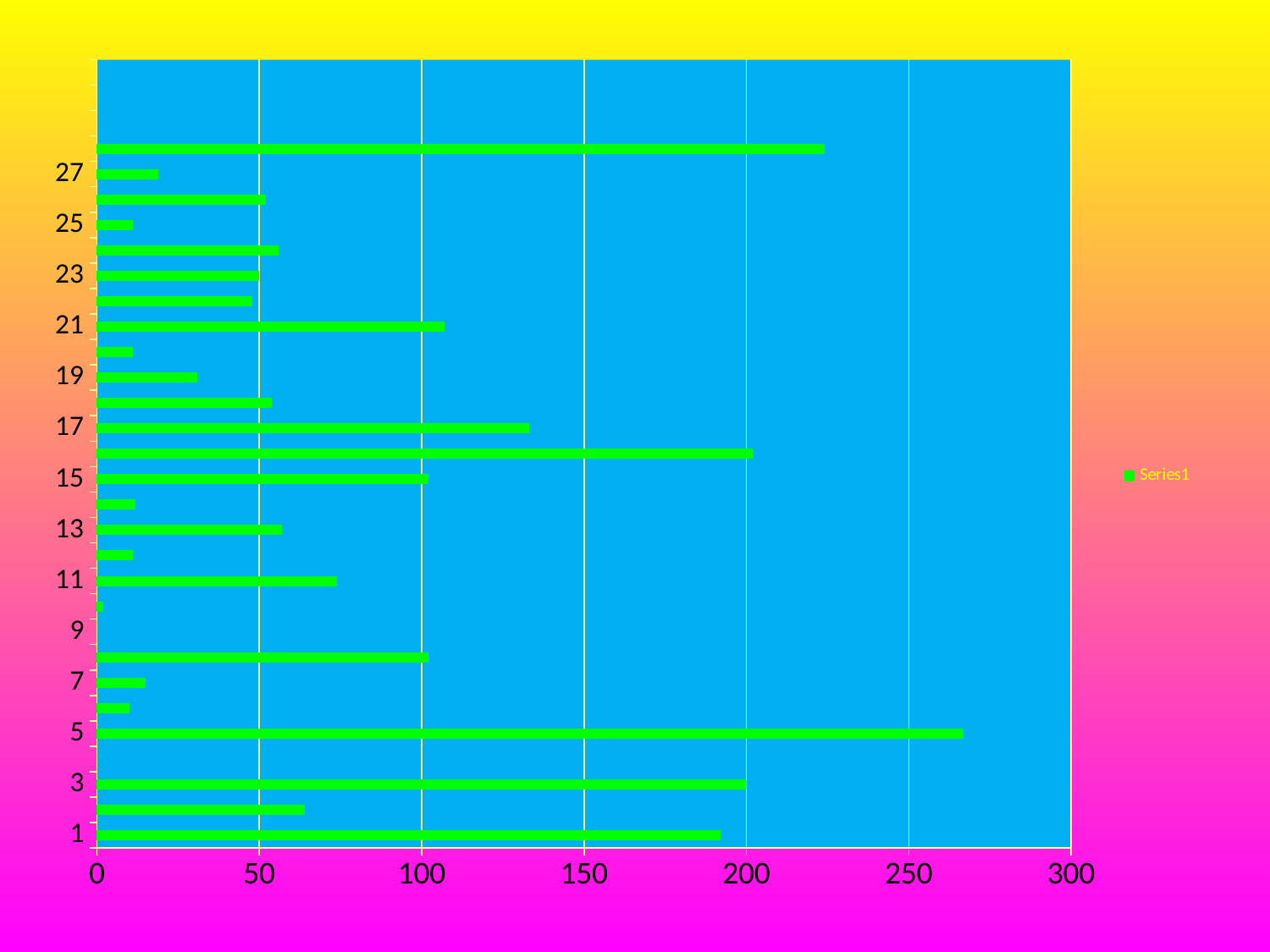
Which category has the highest value? 5 Is the value for category 19 greater or less than 50? less Is the value for category 5 greater or less than 250? greater Is the value for category 17 greater or less than 100? greater Which is larger, the value for category 17 or the value for category 11? 17 What kind of chart is shown on the slide? bar chart Which is larger, the value for category 13 or the value for category 7? 13 What is the name of the series shown in the legend? Series1 How many series does the legend list? 1